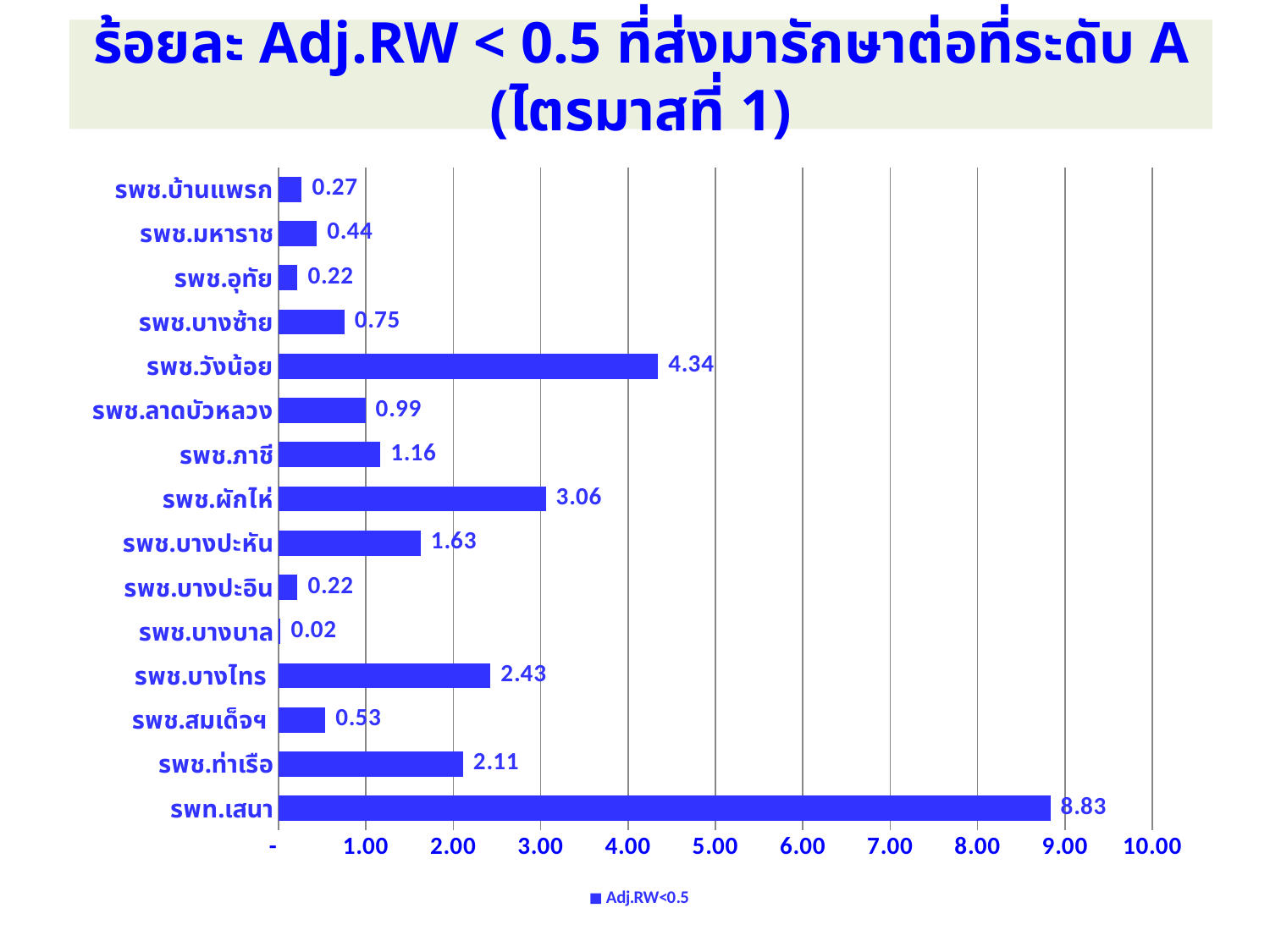
What value is shown for รพช.ผักไห่? 3.06 Which is larger, the value for รพช.ผักไห่ or รพช.บางไทร? รพช.ผักไห่ What value is shown for รพช.วังน้อย? 4.34 Which hospital has the highest value? รพท.เสนา How many hospitals are shown on the chart? 15 What value is shown for รพท.เสนา? 8.83 What is the difference between the values for รพท.เสนา and รพช.วังน้อย? 4.49 What kind of chart is shown on the slide? Bar chart Which hospital has the lowest value? รพช.บางบาล What series name does the legend show? Adj.RW<0.5 What is the difference between the values for รพช.บางไทร and รพช.ท่าเรือ? 0.32 What value is shown for รพช.บางปะหัน? 1.63